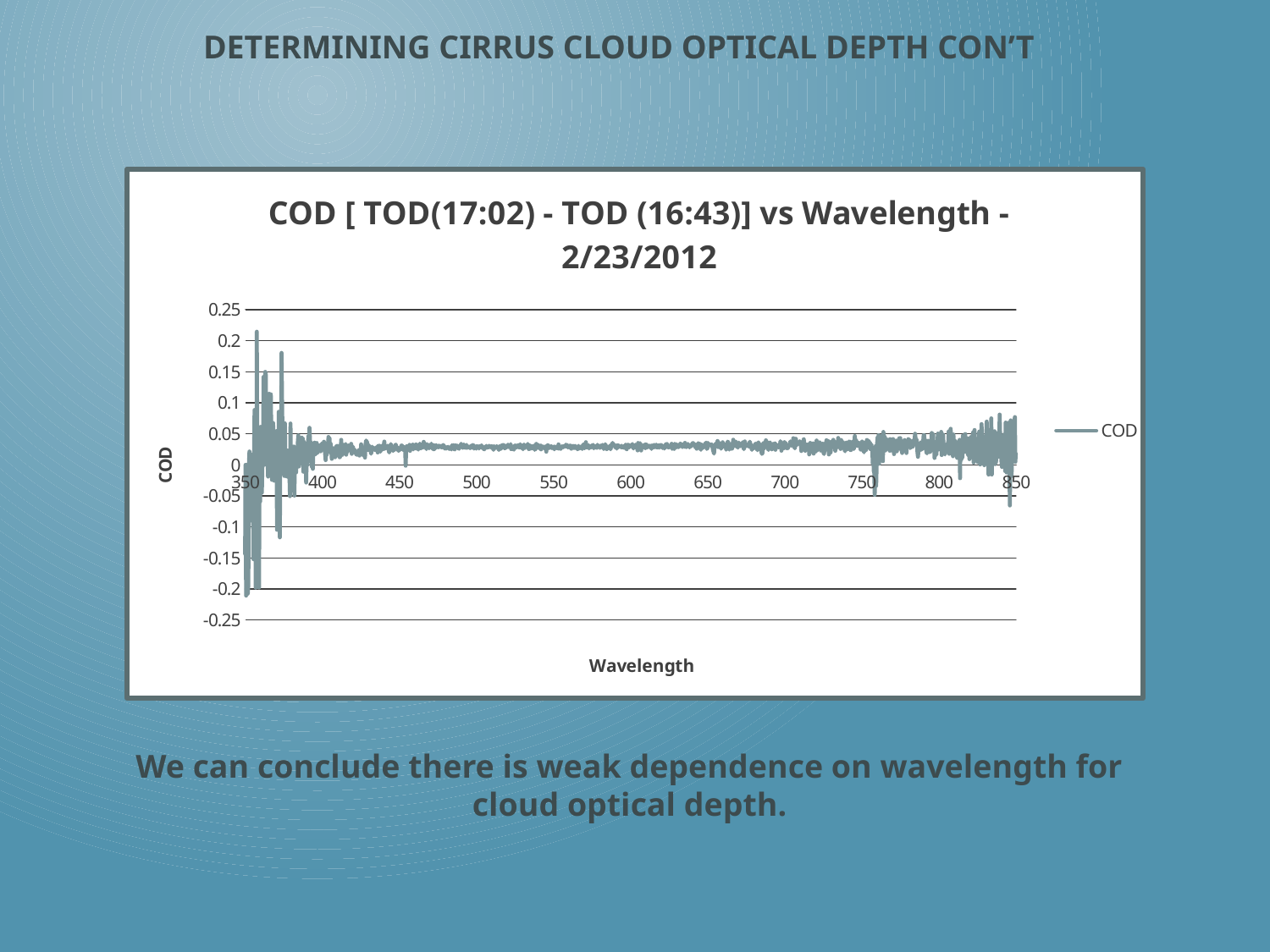
What is the highest value shown on the y axis? 0.25 Is the COD value at a wavelength of 600 greater or less than 0.1? less What is the name of the series shown in the legend? COD Is the COD value at a wavelength of 600 greater or less than 0? greater Between wavelengths 450 and 750, does the COD line rise strongly, fall strongly, or stay roughly flat? roughly flat How many tick labels are shown on the x axis? 11 What kind of chart is shown on the slide? line chart Is the COD value at a wavelength of 700 greater or less than -0.1? greater What is the title of the chart? COD [ TOD(17:02) - TOD (16:43)] vs Wavelength - 2/23/2012 How many series does the legend list? 1